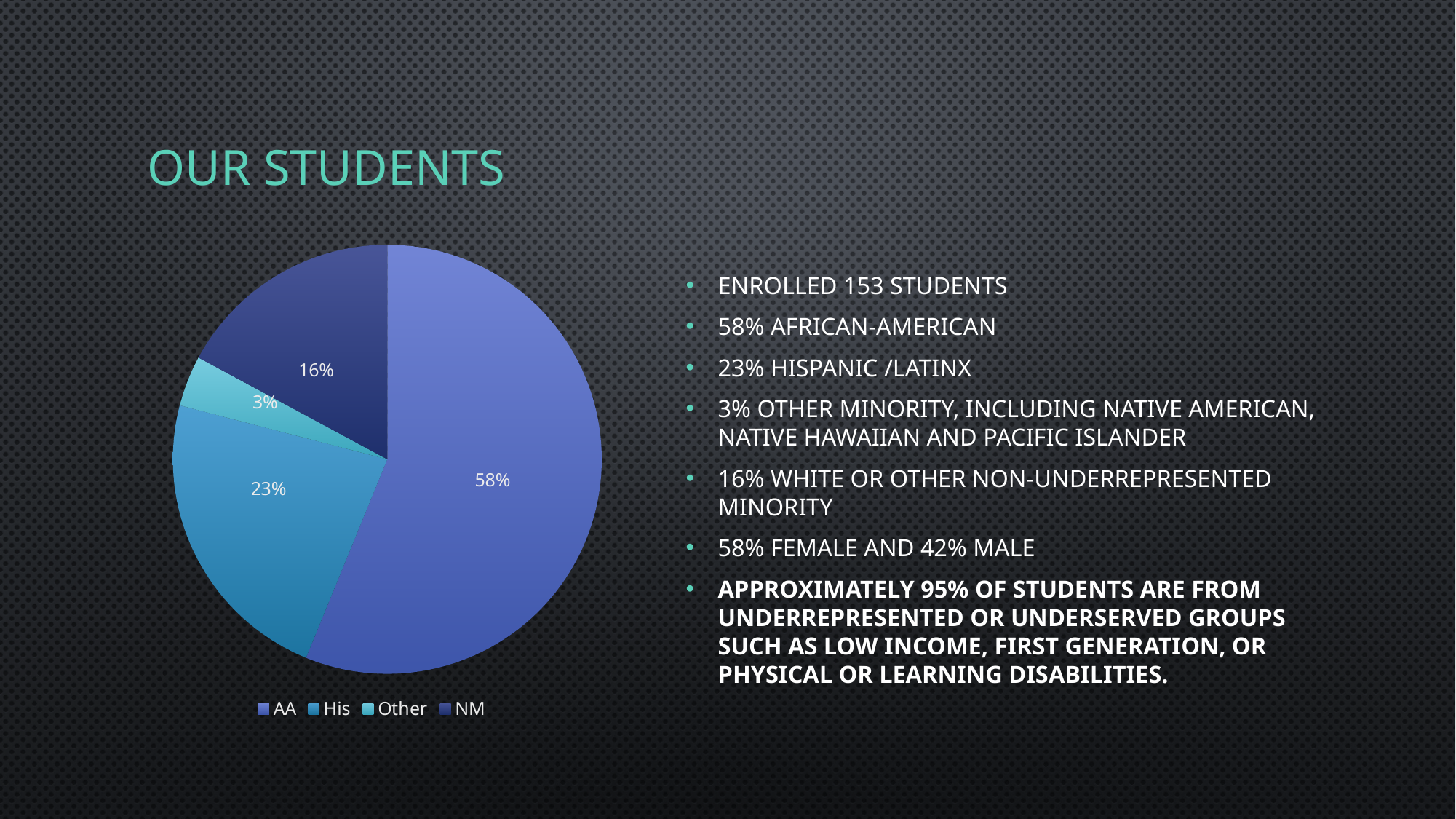
What is the difference in percentage points between the AA slice and the His slice? 35 How many slices does the pie chart have? 4 What percentage does the His slice represent? 23% What percentage does the Other slice represent? 3% Which category has the smallest slice of the pie? Other What percentage does the NM slice represent? 16% What are the legend entries, in order from left to right? AA, His, Other, NM What kind of chart is shown on the slide? pie chart Which category has the largest slice of the pie? AA Which slice is larger, His or NM? His How many entries does the legend list? 4 What percentage does the AA slice represent? 58%